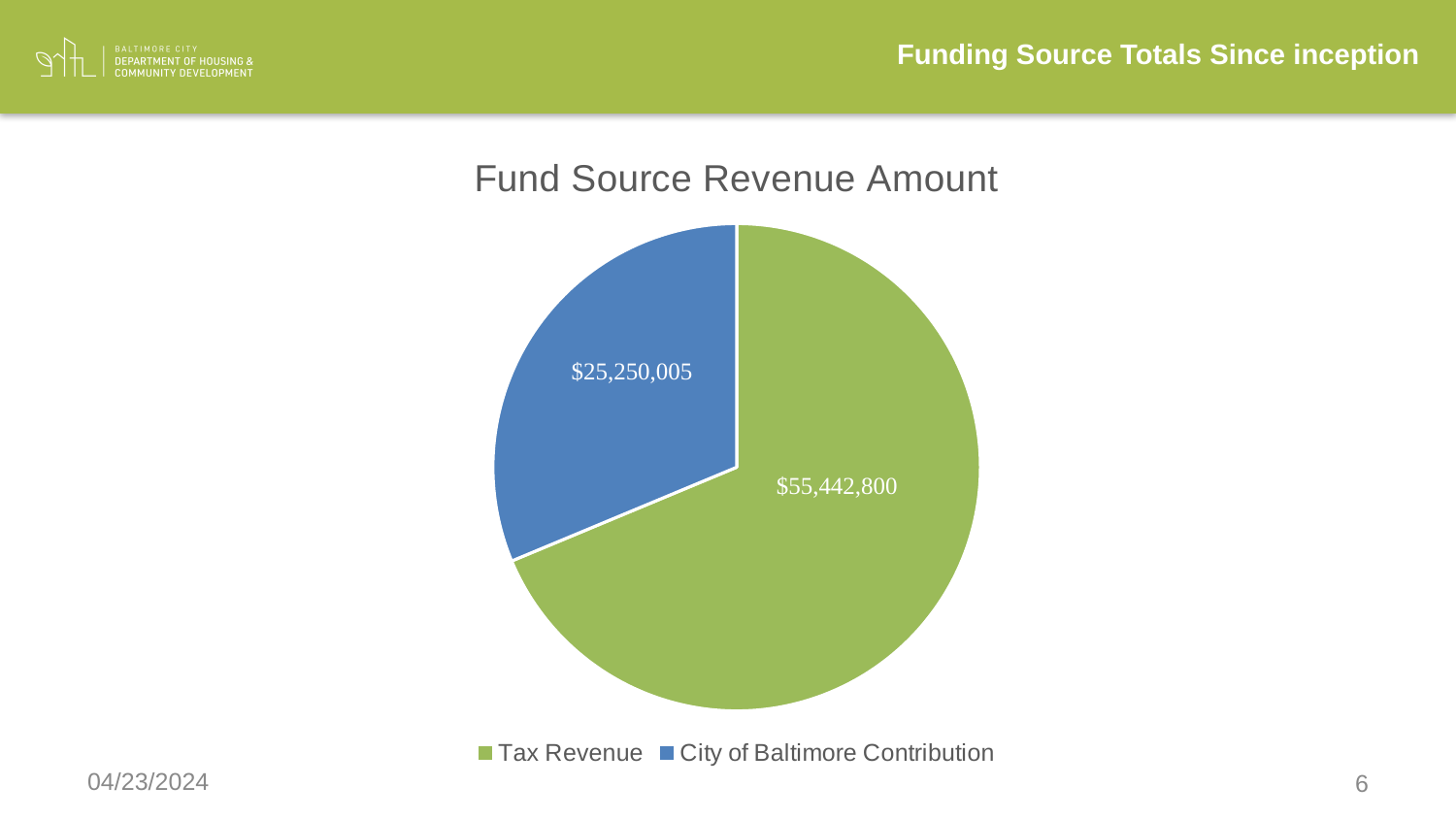
How many entries does the legend list? 2 What is the value for Tax Revenue in the pie chart? $55,442,800 Which fund source has the largest slice of the pie? Tax Revenue How many slices does the pie chart have? 2 What kind of chart is shown on the slide? Pie chart Which is larger, Tax Revenue or City of Baltimore Contribution? Tax Revenue Which fund source has the smallest slice of the pie? City of Baltimore Contribution What is the value for City of Baltimore Contribution in the pie chart? $25,250,005 What is the title of the pie chart? Fund Source Revenue Amount What is the difference between Tax Revenue and City of Baltimore Contribution? $30,192,795 What is the total of the two fund sources shown in the pie chart? $80,692,805 To the nearest whole percent, what share of the pie does Tax Revenue represent? 69%